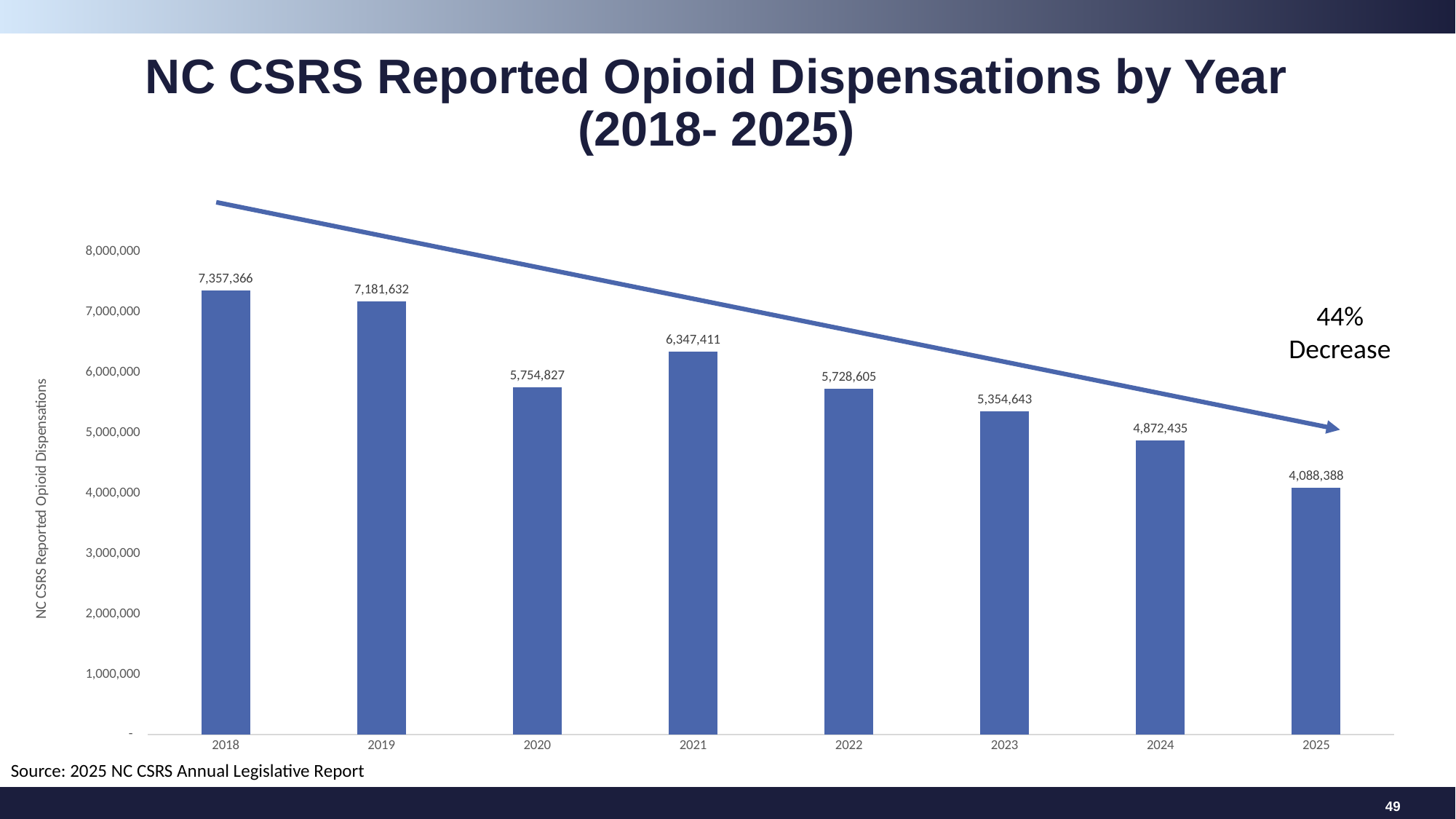
What is the difference between the 2018 and 2025 values? 3,268,978 What kind of chart is shown on the slide? Bar chart What is the number of reported opioid dispensations for 2025? 4,088,388 How many years are shown on the chart? 8 Which year has the highest number of reported opioid dispensations? 2018 What is the number of reported opioid dispensations for 2021? 6,347,411 What is the difference between the 2021 and 2020 values? 592,584 Which year has more reported opioid dispensations, 2021 or 2023? 2021 What percentage decrease is annotated on the chart? 44% Is the value for 2024 greater or less than 5,000,000? less Which year has the lowest number of reported opioid dispensations? 2025 What is the number of reported opioid dispensations for 2018? 7,357,366